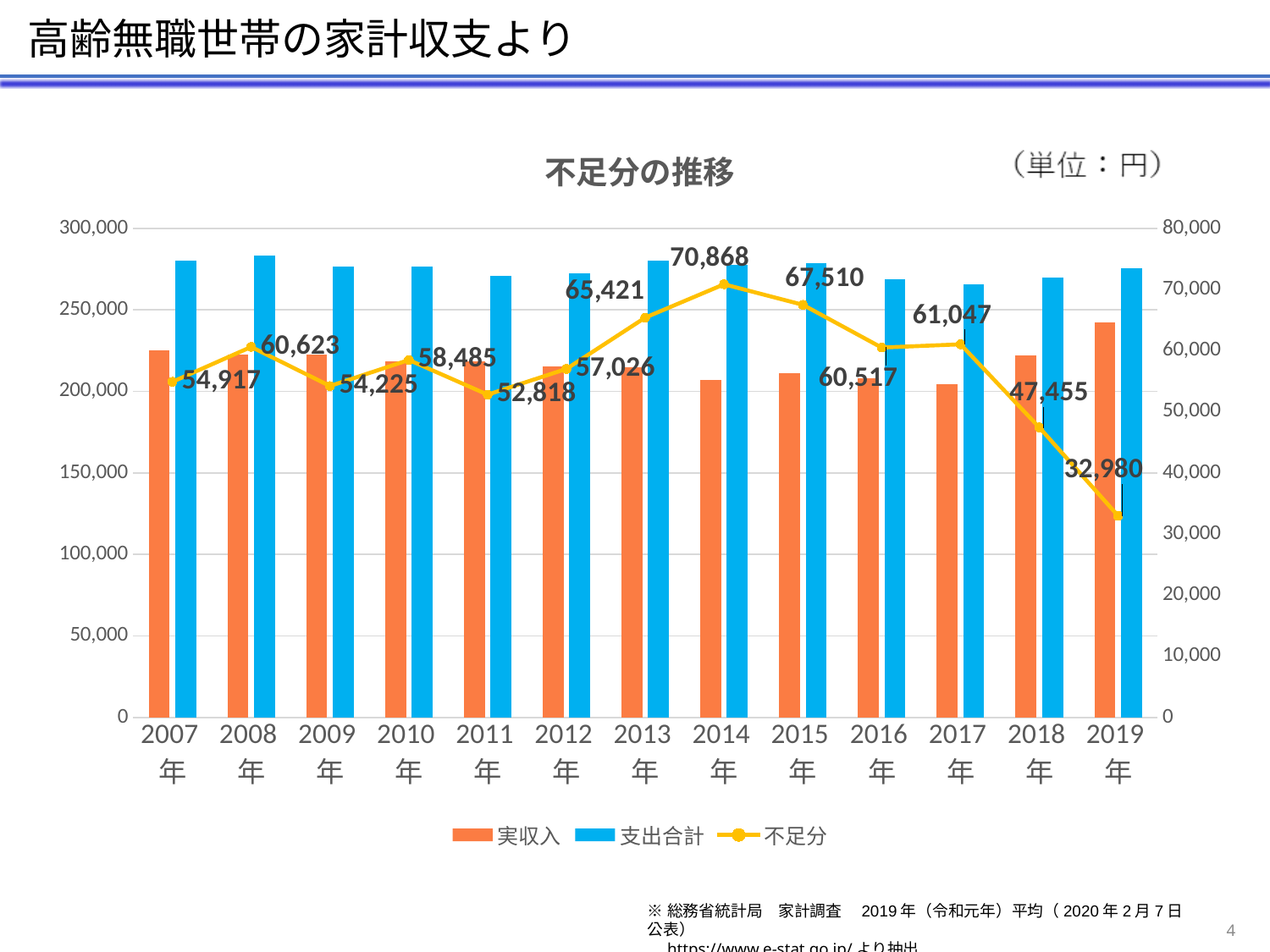
In which year is 不足分 highest? 2014年 What is the value of 不足分 for 2019年? 32,980 What kind of chart is this? Combination bar and line chart Which year has the larger 不足分, 2008年 or 2009年? 2008年 Is the 実収入 bar for 2019年 greater or less than 200,000? greater What is the difference between 不足分 in 2014年 and 2019年? 37,888 How many series does the legend list? 3 In which year is 不足分 lowest? 2019年 What is the value of 不足分 for 2014年? 70,868 How many years are shown on the x axis? 13 What is the value of 不足分 for 2007年? 54,917 Does 不足分 rise or fall from 2014年 to 2019年? Fall